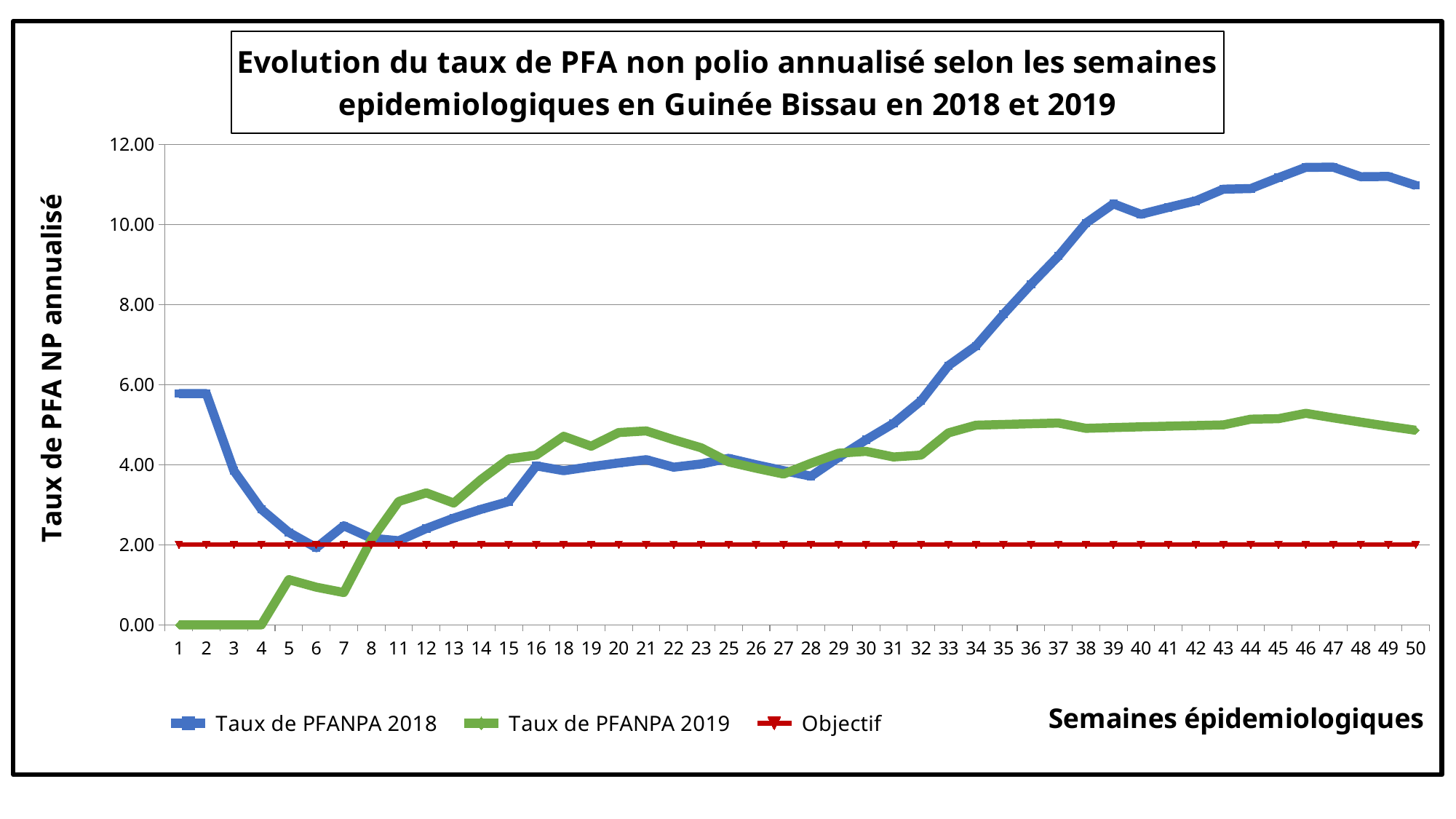
What is the value of the Objectif line? 2.00 How many series does the legend list? 3 What colour is the Objectif line? red What kind of chart is shown on the slide? line chart Is the value of Taux de PFANPA 2019 at week 50 greater or less than 6.00? less Does Taux de PFANPA 2018 rise or fall between week 1 and week 6? fall Is the value of Taux de PFANPA 2018 at week 50 greater or less than 10.00? greater How many epidemiological weeks are labelled on the x axis? 46 At week 18, which series is higher: Taux de PFANPA 2018 or Taux de PFANPA 2019? Taux de PFANPA 2019 What is the value of Taux de PFANPA 2019 at week 1? 0.00 At week 50, which series is higher: Taux de PFANPA 2018 or Taux de PFANPA 2019? Taux de PFANPA 2018 Does Taux de PFANPA 2018 rise or fall between week 30 and week 46? rise